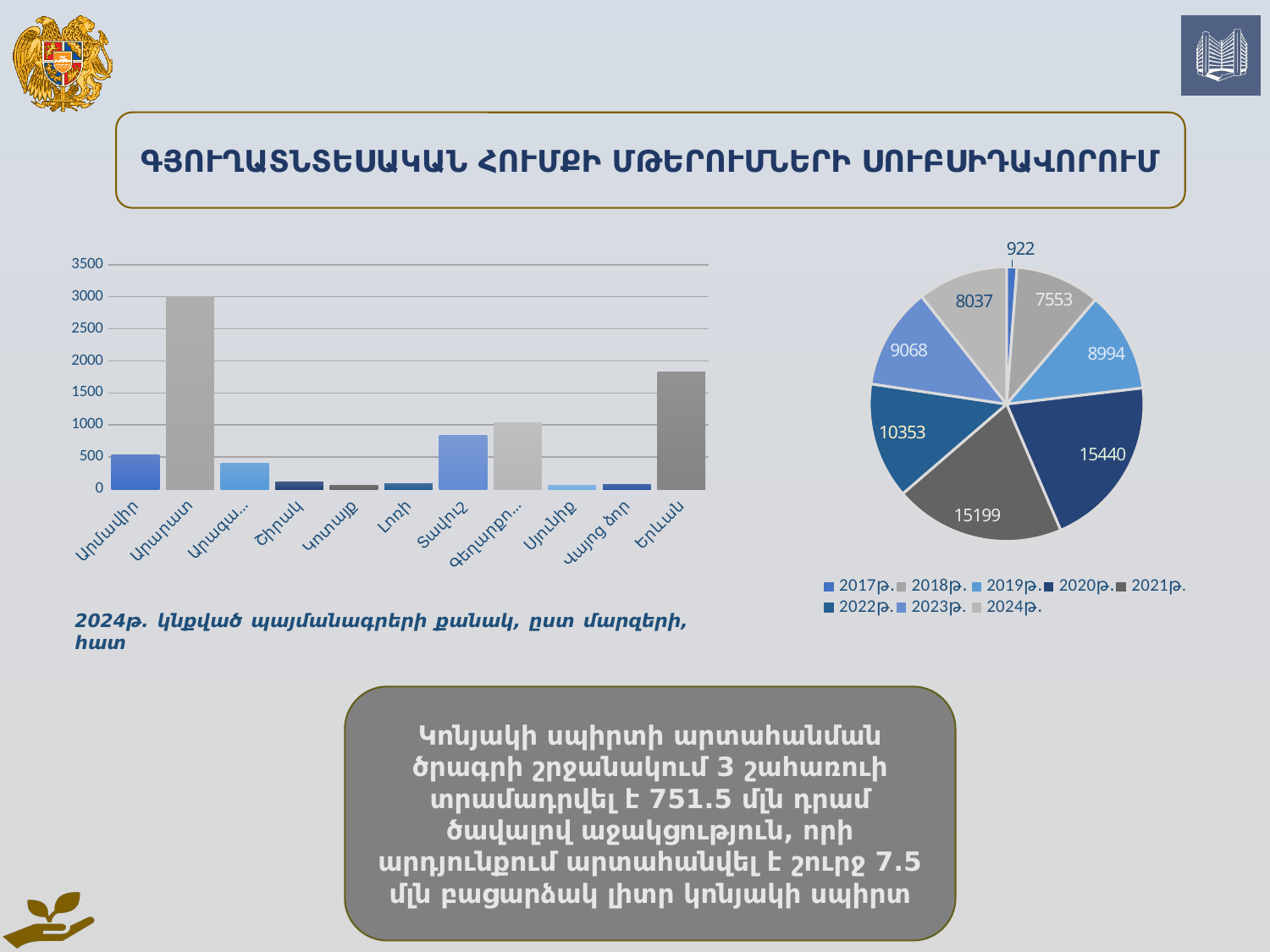
In the pie chart on the right, what is the difference between the values for 2020թ. and 2021թ.? 241 How many series does the legend of the pie chart on the right list? 8 In the pie chart on the right, which year has the smallest slice? 2017թ. In the bar chart on the left, how many regions (categories) are shown on the x axis? 11 In the bar chart on the left, is the value for Երևան greater or less than 1500? greater What type of chart is shown on the left side of the slide? bar chart In the bar chart on the left, is the value for Տավուշ greater or less than 1000? less In the bar chart on the left, is the value for Արարատ greater or less than 2500? greater In the bar chart on the left, which region has the highest bar? Արարատ In the pie chart on the right, what is the value for 2020թ.? 15440 What type of chart is shown on the right side of the slide? pie chart In the bar chart on the left, which has the larger value, Արարատ or Երևան? Արարատ